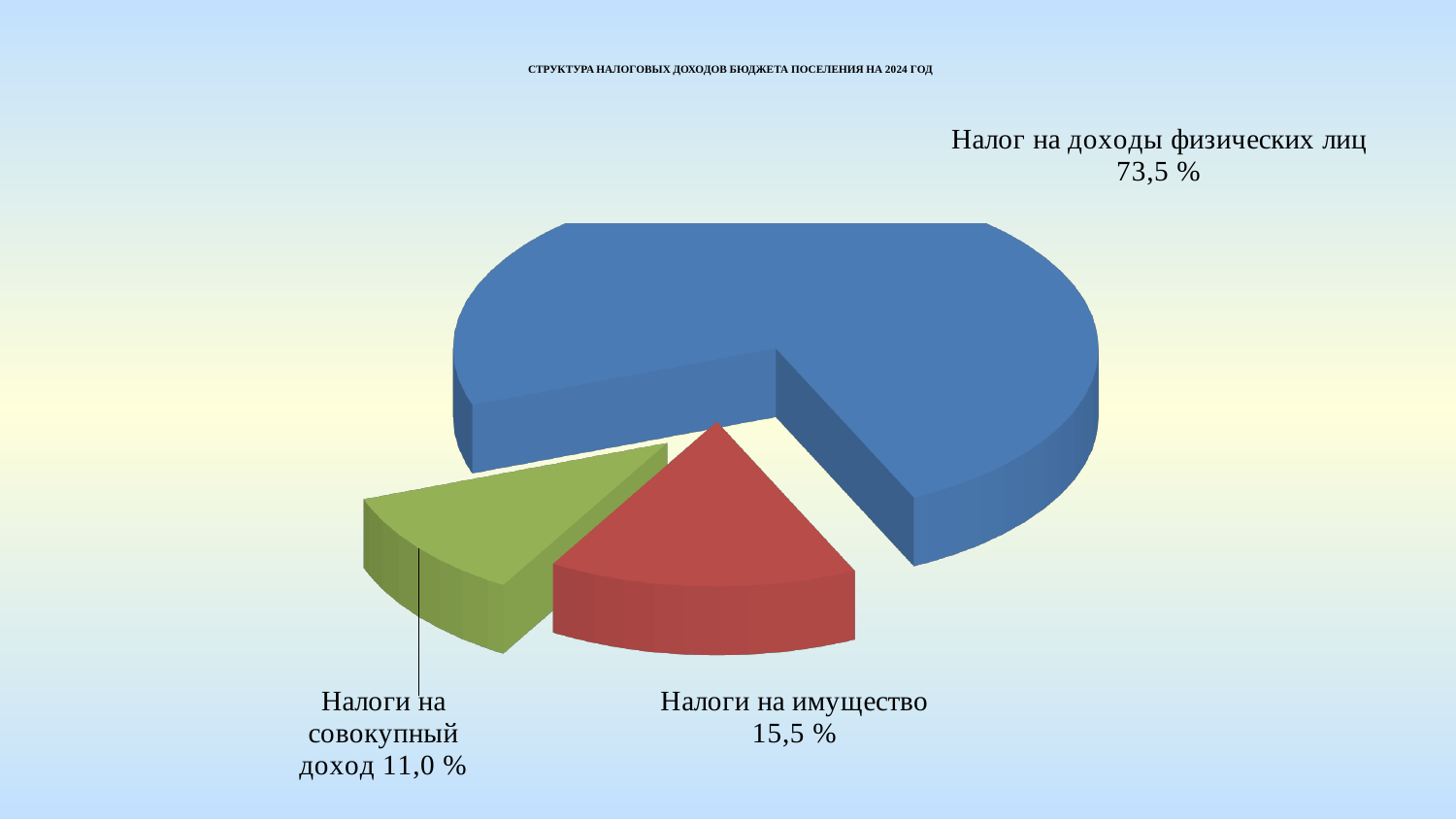
Which is larger: Налоги на имущество or Налоги на совокупный доход? Налоги на имущество What is the difference in percentage points between Налоги на имущество and Налоги на совокупный доход? 4,5 What is the title of the chart? СТРУКТУРА НАЛОГОВЫХ ДОХОДОВ БЮДЖЕТА ПОСЕЛЕНИЯ НА 2024 ГОД Which category has the largest slice of the pie? Налог на доходы физических лиц What is the value shown for Налоги на имущество? 15,5 % How many slices does the pie chart have? 3 What share of the pie does Налог на доходы физических лиц represent? 73,5 % Which category has the smallest slice of the pie? Налоги на совокупный доход What kind of chart is shown on the slide? Pie chart What is the difference in percentage points between Налог на доходы физических лиц and Налоги на имущество? 58,0 What colour is the slice for Налоги на имущество? Red What is the value shown for Налоги на совокупный доход? 11,0 %